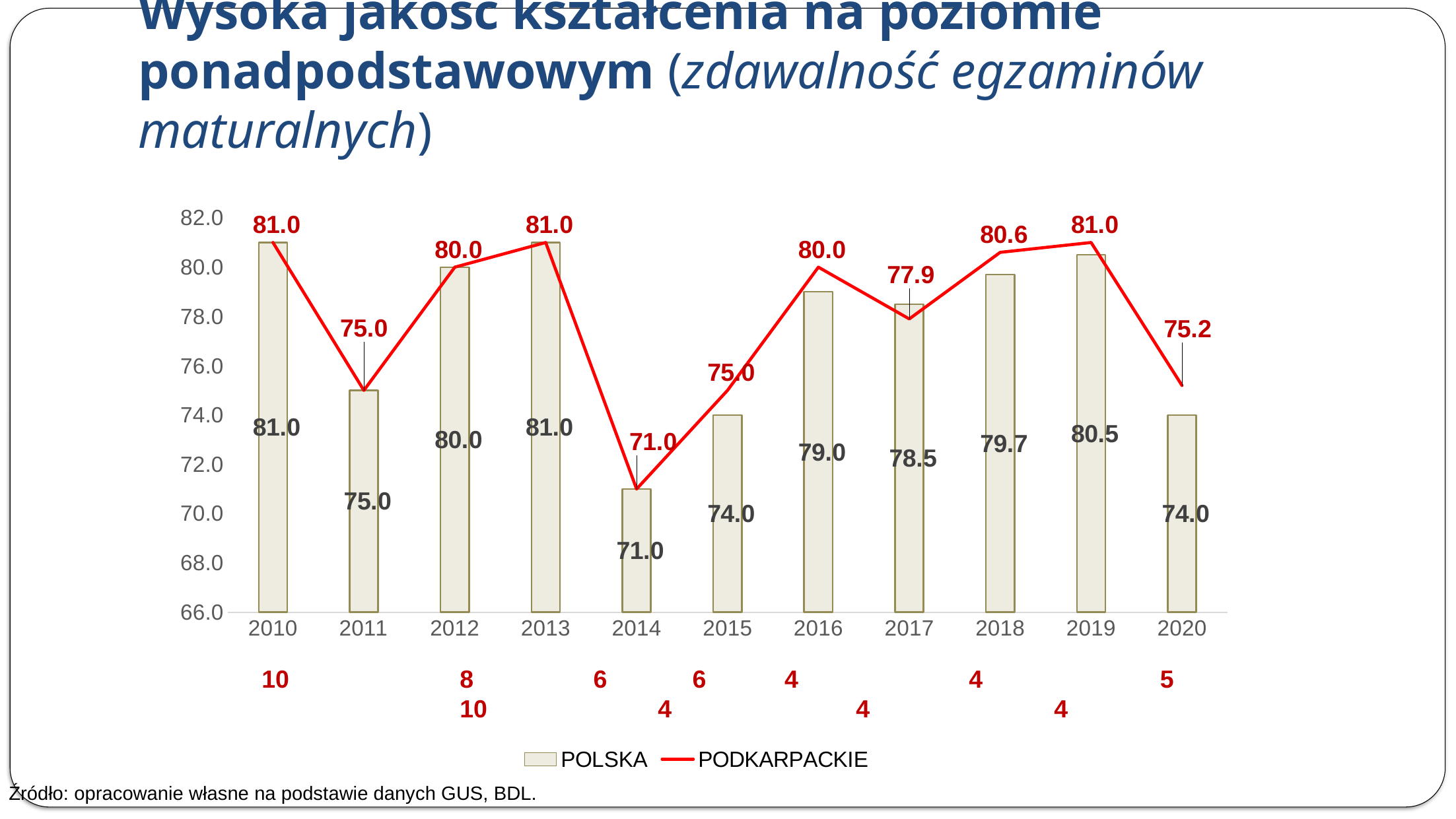
How many years are shown on the x axis? 11 In which year is the PODKARPACKIE value lowest? 2014 What kind of chart is shown on the slide? Combined bar and line chart Does the PODKARPACKIE value rise or fall from 2019 to 2020? Fall What is the difference between the PODKARPACKIE and POLSKA values in 2016? 1.0 In which year is the POLSKA value lowest? 2014 What is the difference between the POLSKA values for 2013 and 2014? 10.0 How many series does the legend list? 2 What is the PODKARPACKIE value for 2020? 75.2 What is the PODKARPACKIE value for 2018? 80.6 In 2017, which is larger: the POLSKA value or the PODKARPACKIE value? POLSKA What is the POLSKA value for 2019? 80.5